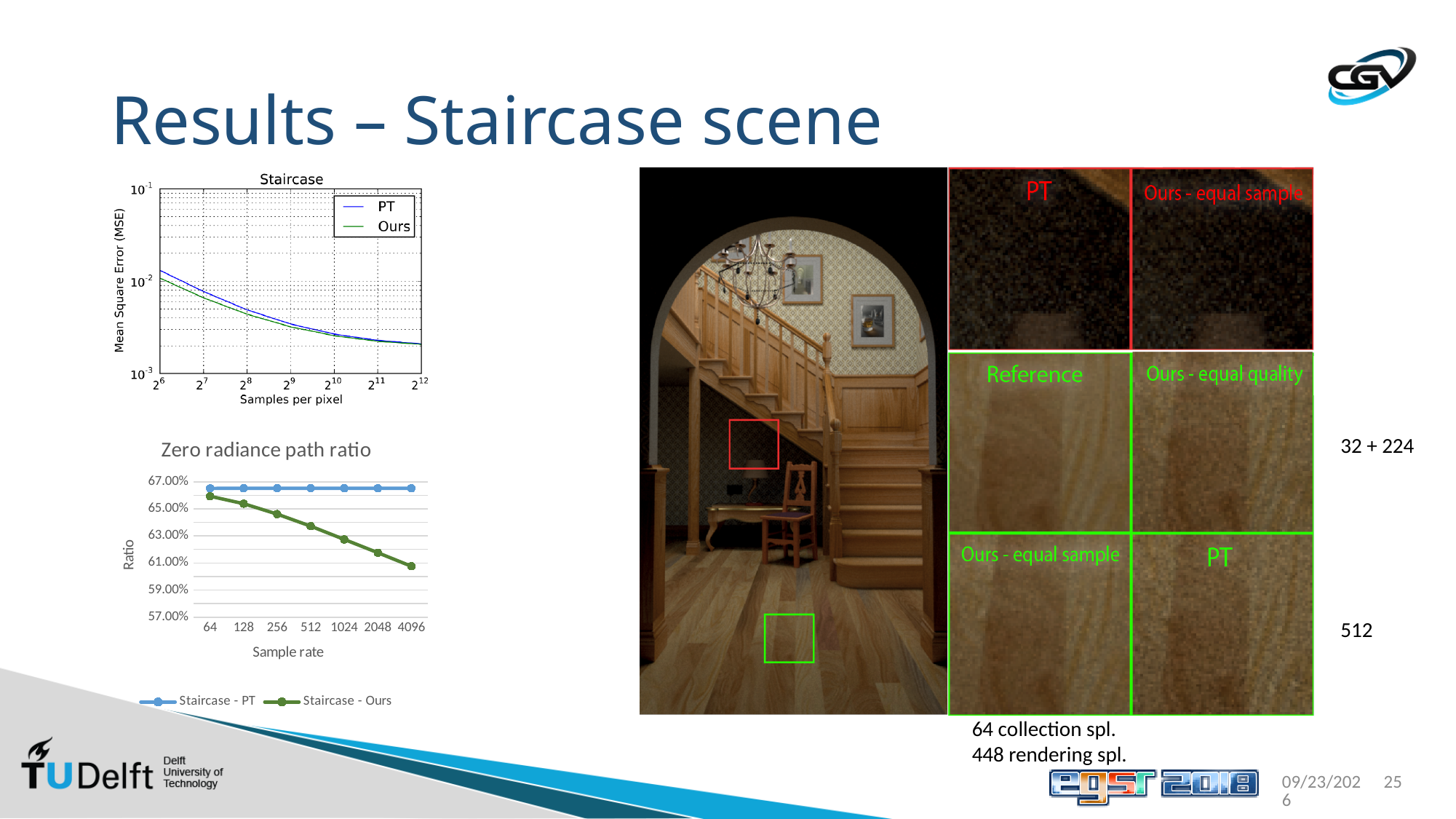
In the 'Staircase' chart, what is the label of the y axis? Mean Square Error (MSE) In the 'Staircase' chart, does the MSE for PT rise or fall as samples per pixel increase? fall In the 'Staircase' chart, at 2^6 samples per pixel, which series has the higher MSE, PT or Ours? PT How many sample rate points are plotted in the 'Zero radiance path ratio' chart? 7 In the 'Staircase' chart, is the MSE for PT at 2^6 samples per pixel greater or less than 10^-2? greater How many series does the legend of the 'Staircase' chart list? 2 In the 'Zero radiance path ratio' chart, at a sample rate of 4096, which series has the higher ratio, 'Staircase - PT' or 'Staircase - Ours'? Staircase - PT What kind of chart is the 'Staircase' chart at the top left of the slide? line chart In the 'Zero radiance path ratio' chart, is the ratio for 'Staircase - Ours' at a sample rate of 4096 greater or less than 63.00%? less What kind of chart is the 'Zero radiance path ratio' chart? line chart In the 'Zero radiance path ratio' chart, does the ratio for 'Staircase - Ours' rise or fall as the sample rate increases? fall In the 'Staircase' chart, what is the label of the x axis? Samples per pixel